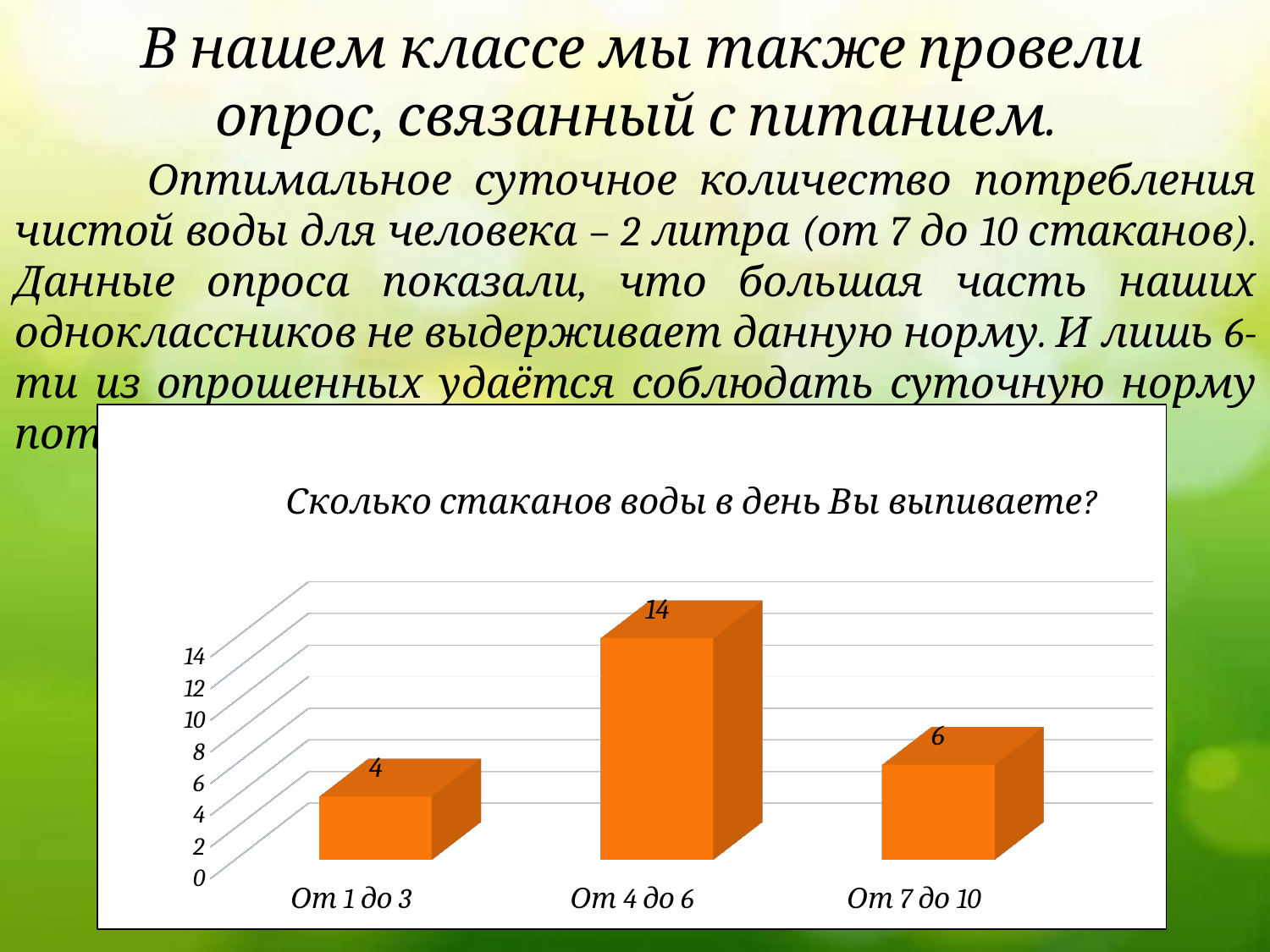
What is the value for the category "От 1 до 3"? 4 Which is larger, the value for "От 7 до 10" or the value for "От 1 до 3"? От 7 до 10 What is the difference between the values for "От 7 до 10" and "От 1 до 3"? 2 What is the title of the chart? Сколько стаканов воды в день Вы выпиваете? Is the value for "От 4 до 6" greater or less than 10? greater Which category has the lowest value? От 1 до 3 What kind of chart is shown on the slide? bar chart How many categories are shown on the chart? 3 What is the value for the category "От 7 до 10"? 6 Which category has the highest value? От 4 до 6 What is the difference between the values for "От 4 до 6" and "От 7 до 10"? 8 What is the value for the category "От 4 до 6"? 14